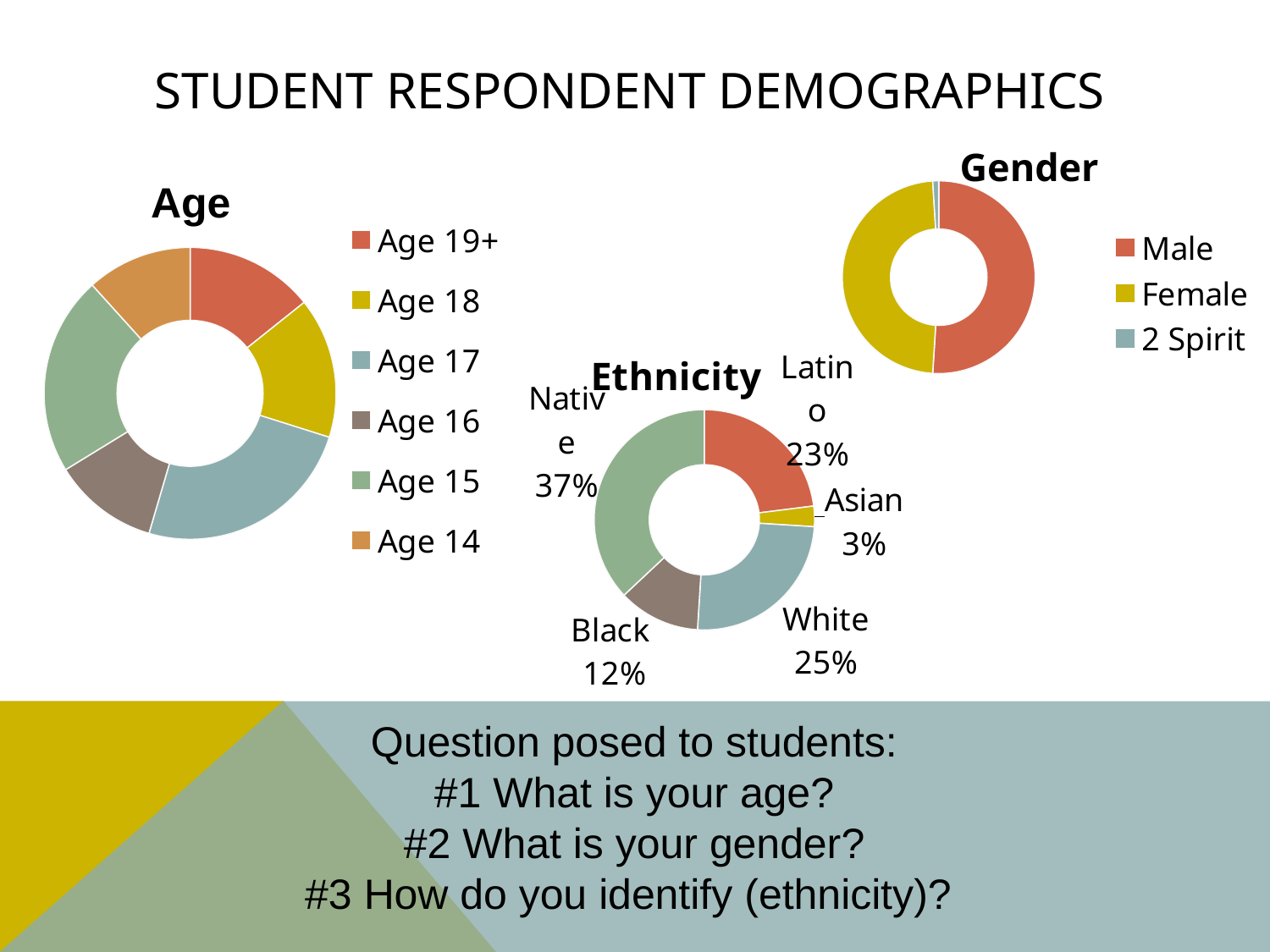
In the Ethnicity chart, which is larger, the share for Latino or the share for White? White In the Ethnicity chart, what is the difference in percentage points between Native and White? 12% What type of chart is the Gender chart? Doughnut chart In the Ethnicity chart, which ethnicity has the smallest share? Asian How many ethnicity categories are shown in the Ethnicity chart? 5 In the Ethnicity chart, what percentage of respondents identified as Native? 37% In the Ethnicity chart, what percentage of respondents identified as Black? 12% How many categories does the legend of the Age chart list? 6 In the Ethnicity chart, which ethnicity has the largest share? Native In the Ethnicity chart, what percentage of respondents identified as White? 25% In the Ethnicity chart, what percentage of respondents identified as Asian? 3% In the Gender chart, which category has the smallest share? 2 Spirit